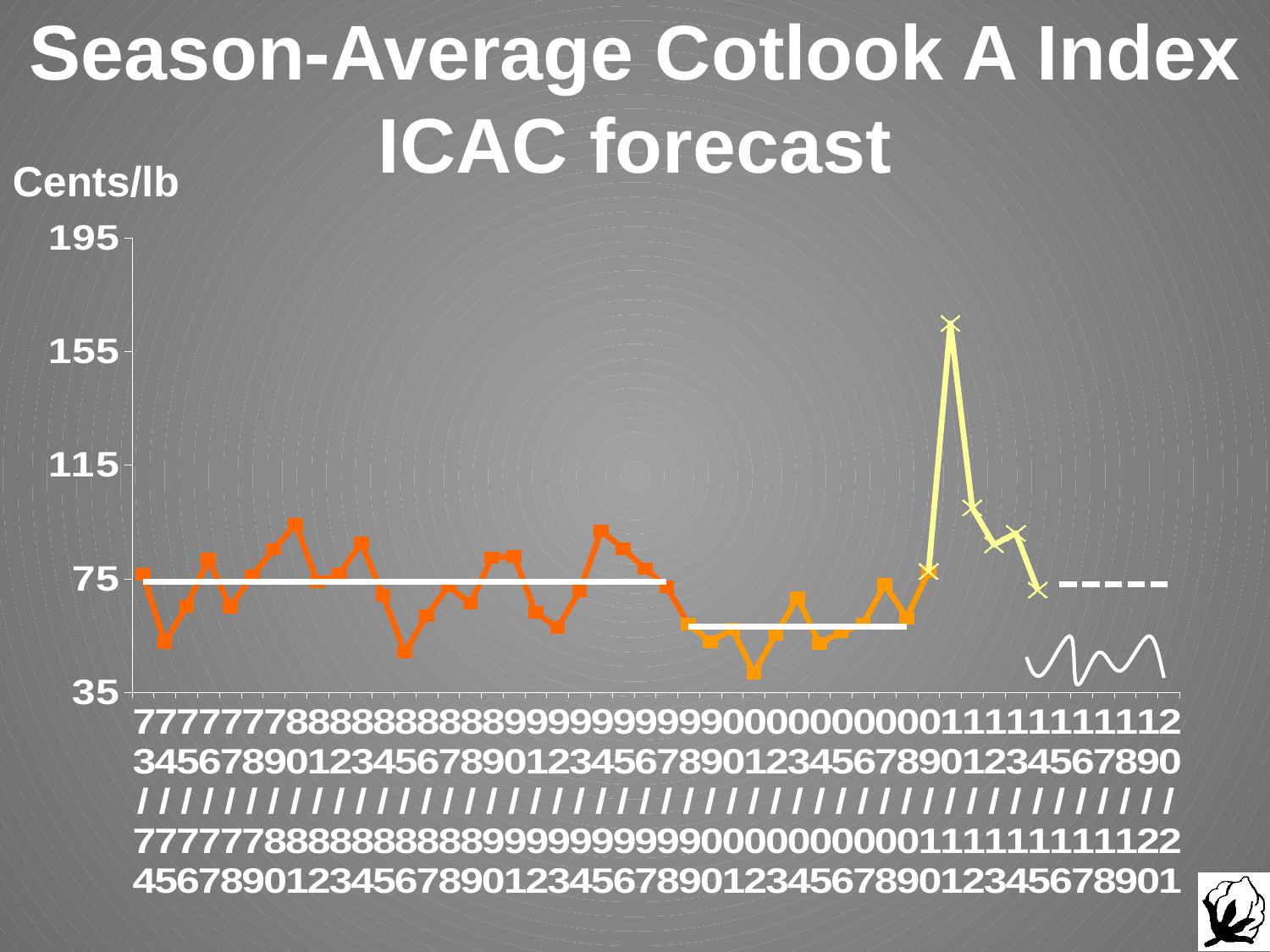
What unit is shown on the vertical axis of the chart? Cents/lb Is the value for season 10/11 greater or less than 115? greater Is the value for season 11/12 greater or less than 75? greater Is the lowest value of the line greater or less than 75? less Which season has the highest value on the chart? 10/11 What is the highest tick value shown on the vertical axis? 195 What is the lowest tick value shown on the vertical axis? 35 What kind of chart is shown on the slide? line chart Do the values rise or fall from season 10/11 to season 14/15? fall Which is larger, the value for 10/11 or the value for 11/12? 10/11 What is the title of the chart? Season-Average Cotlook A Index ICAC forecast